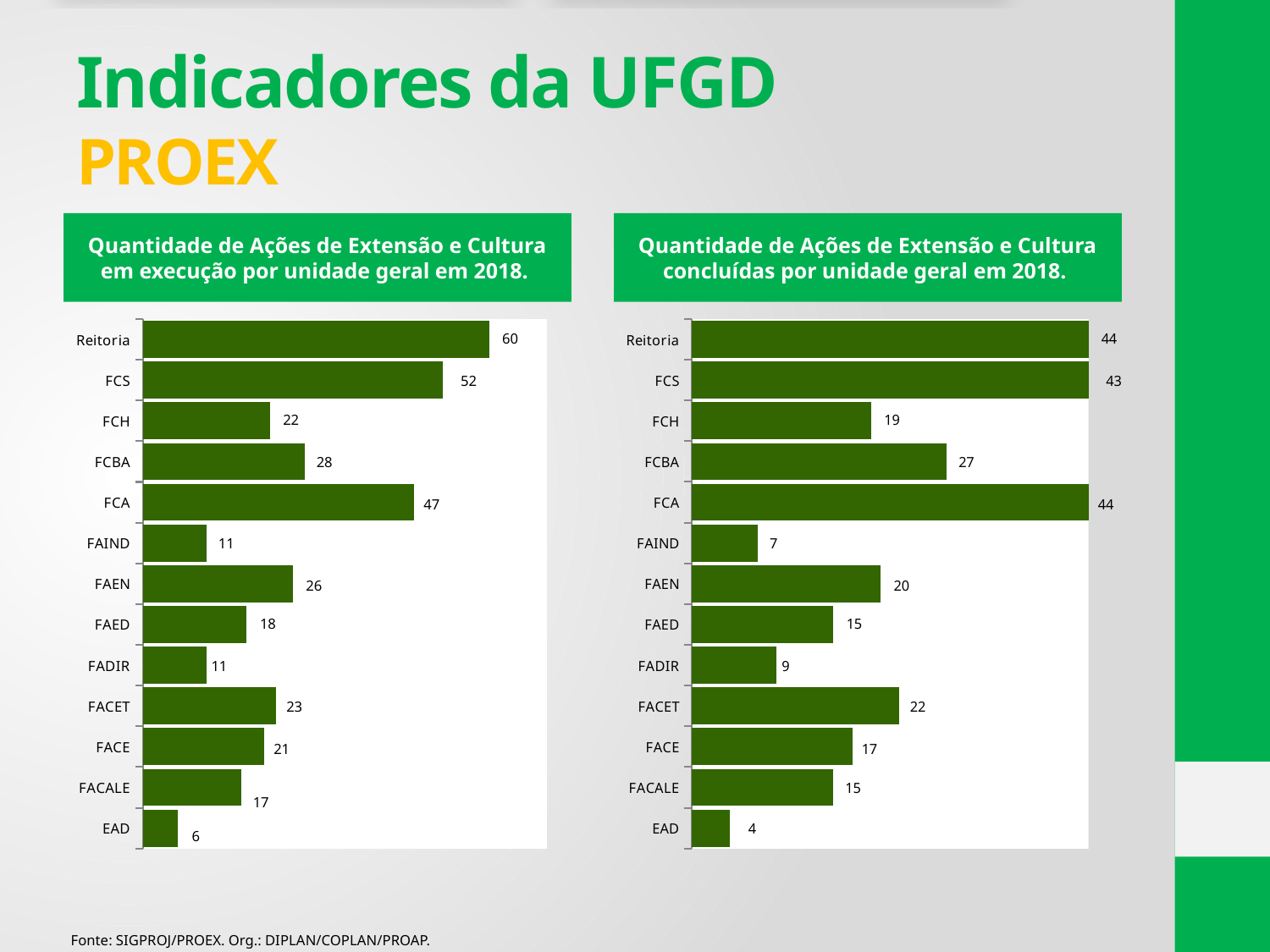
What type of chart is used on the right (ações concluídas)? Bar chart In the left chart (ações em execução), what is the difference between Reitoria and FCS? 8 In the left chart (ações em execução), which unit has the highest value? Reitoria In the right chart (ações concluídas), which unit has the lowest value? EAD In the right chart (ações concluídas), what is the value for FACALE? 15 In the right chart (ações concluídas), which is larger, FAEN or FCH? FAEN In the left chart (ações em execução), which is larger, FCBA or FAEN? FCBA In the left chart (ações em execução), which unit has the lowest value? EAD In the right chart (ações concluídas), what is the difference between FACET and FAIND? 15 In the left chart (ações em execução), what is the value for FCA? 47 In the right chart (ações concluídas), what is the value for FCBA? 27 How many units are shown in the left chart (ações em execução)? 13